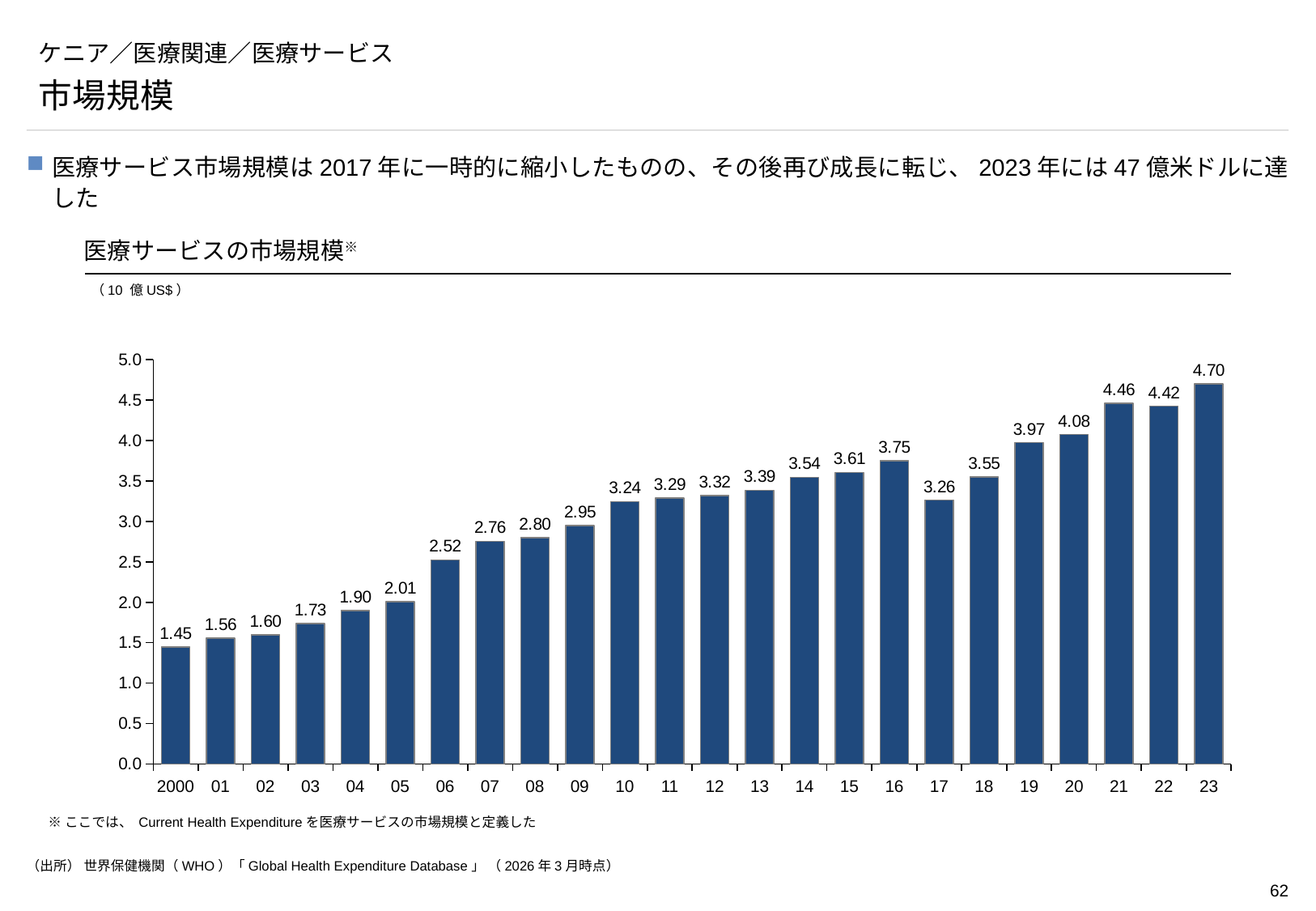
Is the value for 2010 greater or less than 3.0? greater What is the value for 2017? 3.26 What kind of chart is this? bar chart Which year has the highest value? 2023 Which year has the lowest value? 2000 What is the difference between the values for 2023 and 2022? 0.28 Do the values generally rise or fall from 2000 to 2023? rise What is the value for 2000? 1.45 What is the value for 2023? 4.70 What unit is shown for the chart values? 10 億 US$ Which is larger, the value for 2016 or the value for 2017? 2016 How many years are shown on the x axis? 24